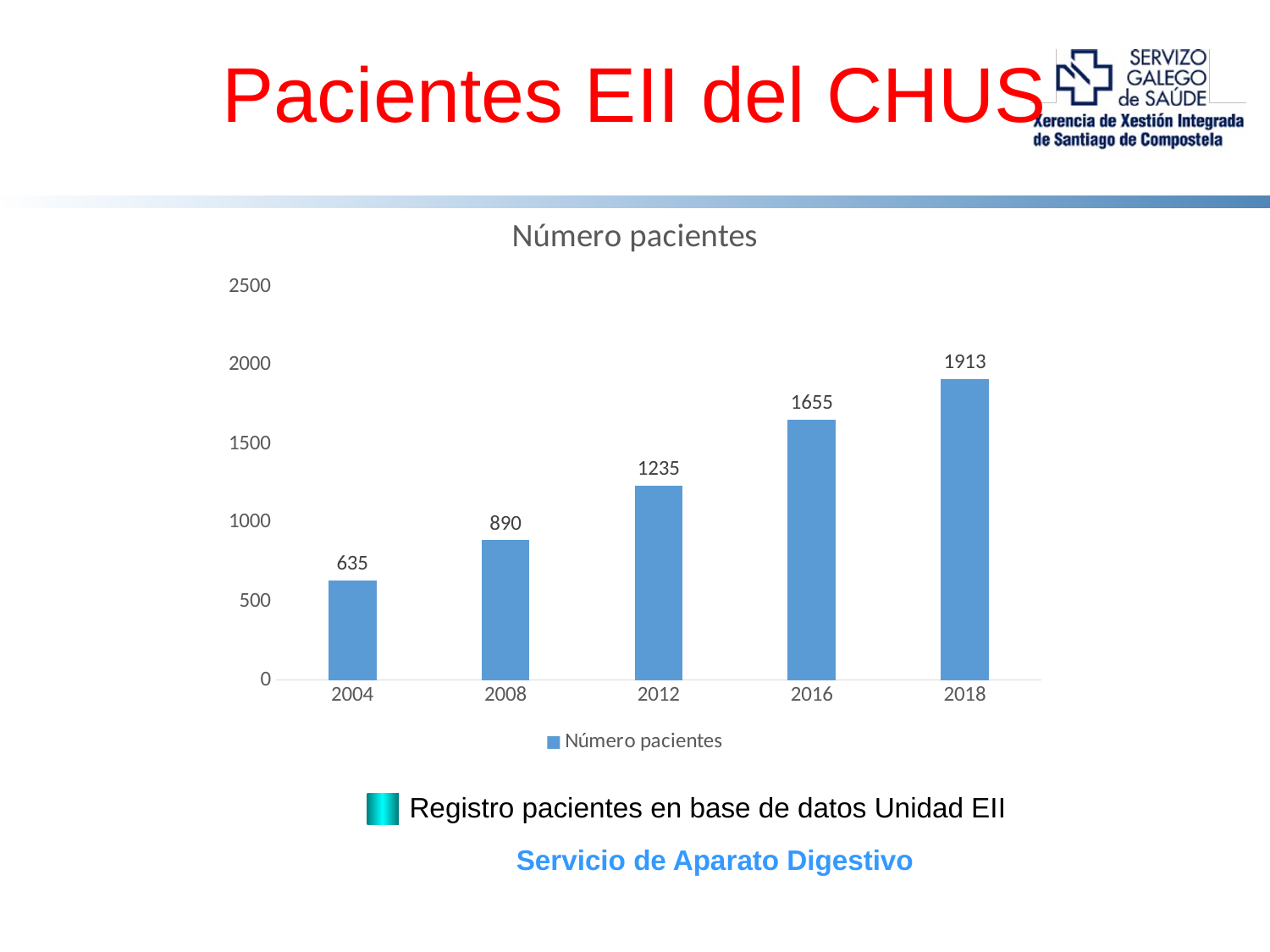
Which year has more patients, 2008 or 2012? 2012 How many years are shown on the x axis of the chart? 5 What kind of chart is shown on the slide? bar chart What is the number of patients in 2012? 1235 What is the number of patients in 2018? 1913 Which year has the highest number of patients? 2018 Is the value for 2016 greater or less than 1500? greater What is the difference in the number of patients between 2008 and 2004? 255 Do the values rise or fall from 2004 to 2018? rise What is the number of patients in 2004? 635 What is the difference in the number of patients between 2018 and 2016? 258 Which year has the lowest number of patients? 2004